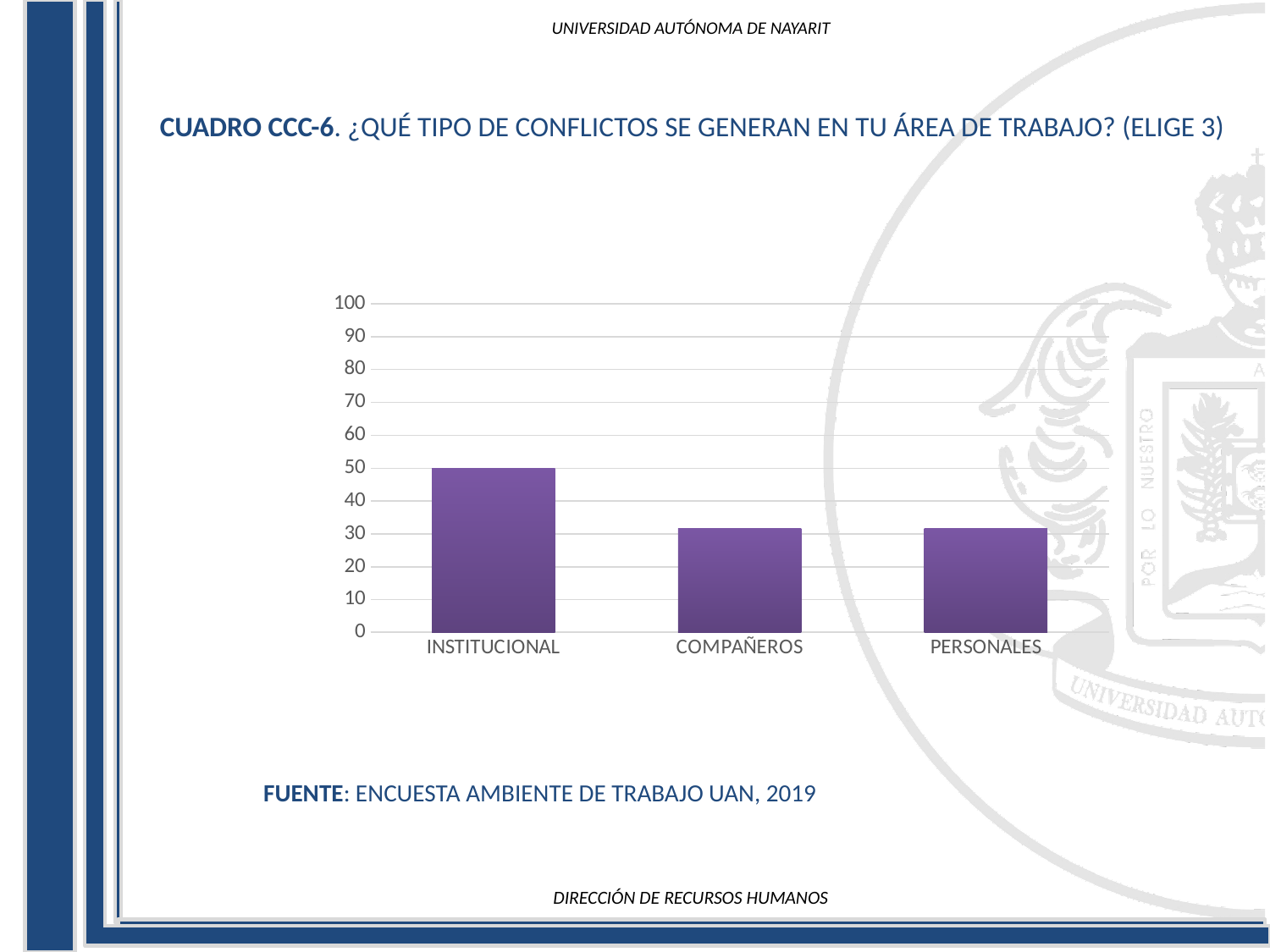
Which is larger, the value for COMPAÑEROS or the value for INSTITUCIONAL? INSTITUCIONAL What is the value for INSTITUCIONAL? 50 How many categories are shown on the x axis of the chart? 3 Is the value for COMPAÑEROS greater or less than 40? less What is the source cited below the chart? ENCUESTA AMBIENTE DE TRABAJO UAN, 2019 What type of chart is shown on the slide? bar chart Is the value for INSTITUCIONAL greater or less than 60? less Which category has the highest value in the chart? INSTITUCIONAL Which is larger, the value for INSTITUCIONAL or the value for PERSONALES? INSTITUCIONAL What is the maximum value shown on the y axis of the chart? 100